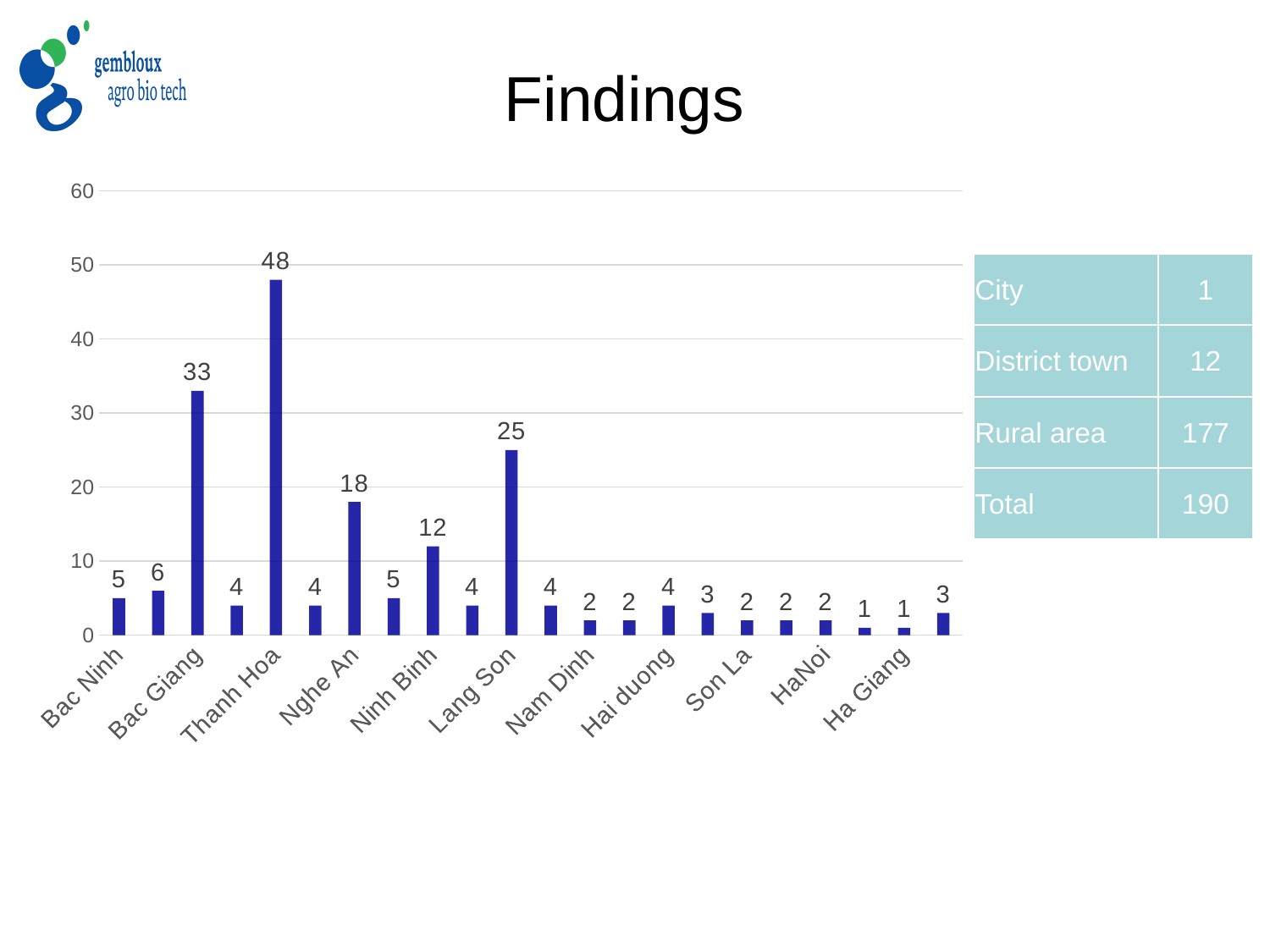
Which labelled category has the highest value? Thanh Hoa What colour are the bars in the chart? blue Is the value for Thanh Hoa greater or less than 40? greater What kind of chart is shown on the slide? bar chart What is the value for Ninh Binh? 12 What is the value for Bac Giang? 33 Which is larger, the value for Lang Son or the value for Nghe An? Lang Son What is the value for Lang Son? 25 What is the difference between the values for Lang Son and Nghe An? 7 What is the difference between the values for Thanh Hoa and Bac Giang? 15 What is the value for Nghe An? 18 What is the value for Thanh Hoa? 48